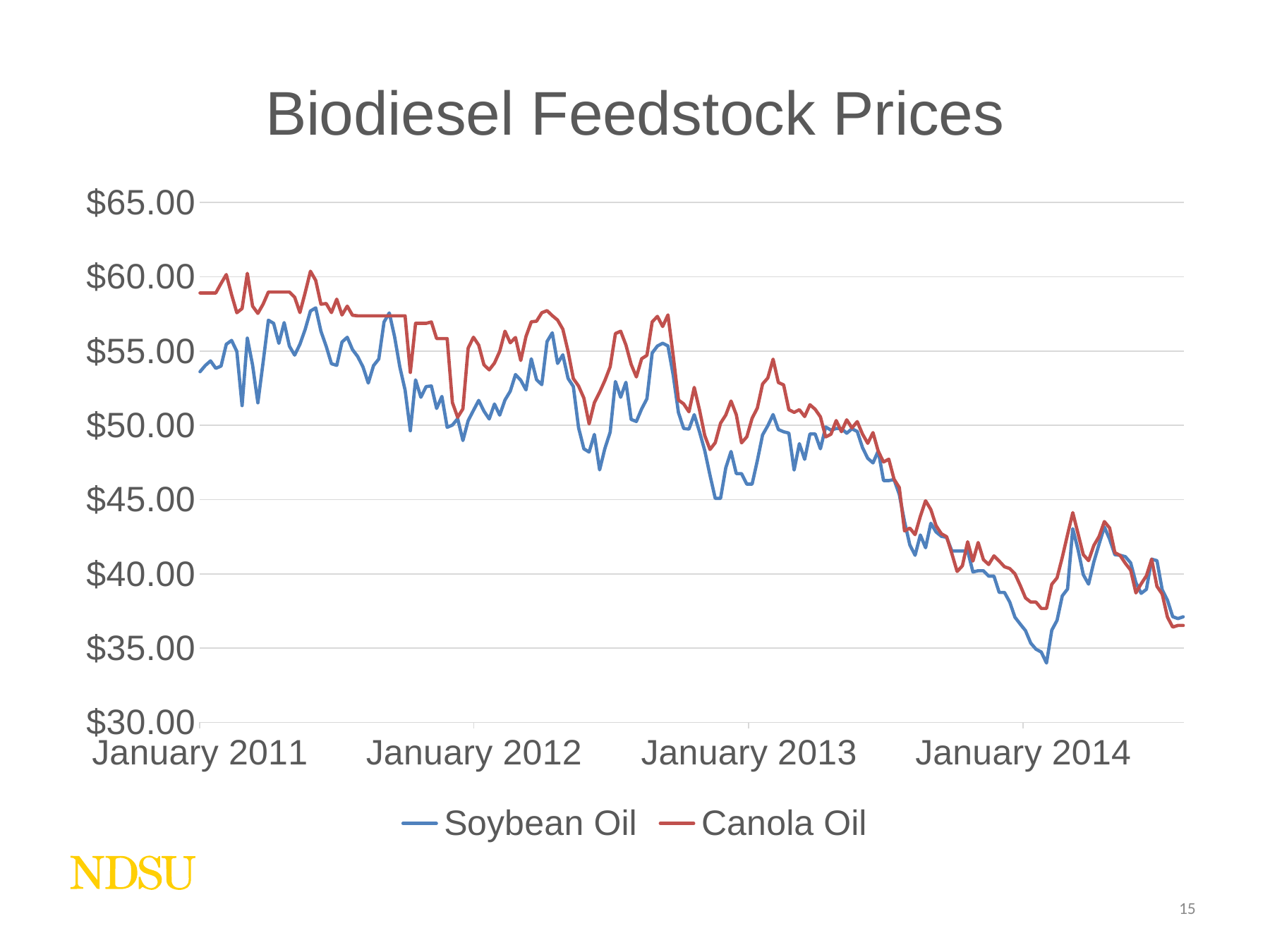
What is the title of the chart? Biodiesel Feedstock Prices At January 2011, which series has the higher price, Soybean Oil or Canola Oil? Canola Oil Is the Canola Oil price at the right end of the chart greater or less than $40.00? less Is the Canola Oil price at January 2011 greater or less than $55.00? greater Do the Soybean Oil prices generally rise or fall from January 2011 to the end of the chart? fall Is the Soybean Oil price at January 2011 greater or less than $50.00? greater Do the Canola Oil prices generally rise or fall across the period shown? fall At January 2012, which series has the higher price, Soybean Oil or Canola Oil? Canola Oil What kind of chart is shown on the slide? line chart Which colour is used for the Soybean Oil line? blue How many series does the legend list? 2